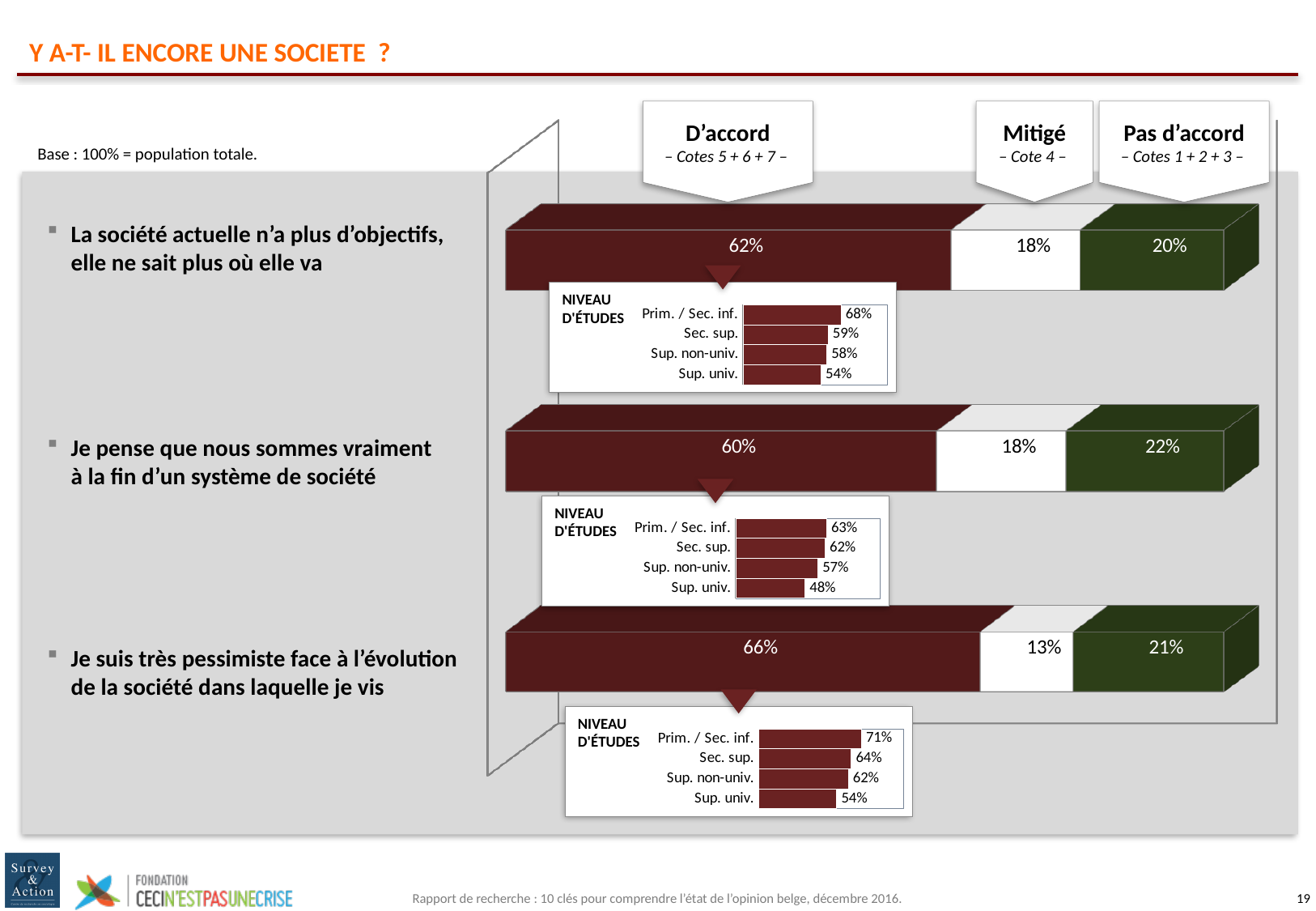
Which of the three statements has the highest D'accord percentage? Je suis très pessimiste face à l'évolution de la société dans laquelle je vis In the Niveau d'études breakdown for "Je suis très pessimiste face à l'évolution de la société dans laquelle je vis", which education level has the highest value? Prim. / Sec. inf. What is the difference between the D'accord and Pas d'accord percentages for the statement "La société actuelle n'a plus d'objectifs, elle ne sait plus où elle va"? 42% In the Niveau d'études breakdown for "Je suis très pessimiste face à l'évolution de la société dans laquelle je vis", what is the difference between Prim. / Sec. inf. and Sup. univ.? 17% In the Niveau d'études breakdown for "Je pense que nous sommes vraiment à la fin d'un système de société", what is the value for Sup. univ.? 48% For the statement "La société actuelle n'a plus d'objectifs, elle ne sait plus où elle va", what percentage is D'accord? 62% In the Niveau d'études breakdown for "La société actuelle n'a plus d'objectifs, elle ne sait plus où elle va", which is larger: Sec. sup. or Sup. non-univ.? Sec. sup. How many education levels are shown in each Niveau d'études breakdown chart? 4 What type of chart is used for the Niveau d'études breakdowns? Bar chart In the Niveau d'études breakdown for "La société actuelle n'a plus d'objectifs, elle ne sait plus où elle va", which education level has the lowest value? Sup. univ. For the statement "Je pense que nous sommes vraiment à la fin d'un système de société", what percentage is Pas d'accord? 22% For the statement "Je suis très pessimiste face à l'évolution de la société dans laquelle je vis", what percentage is Mitigé? 13%